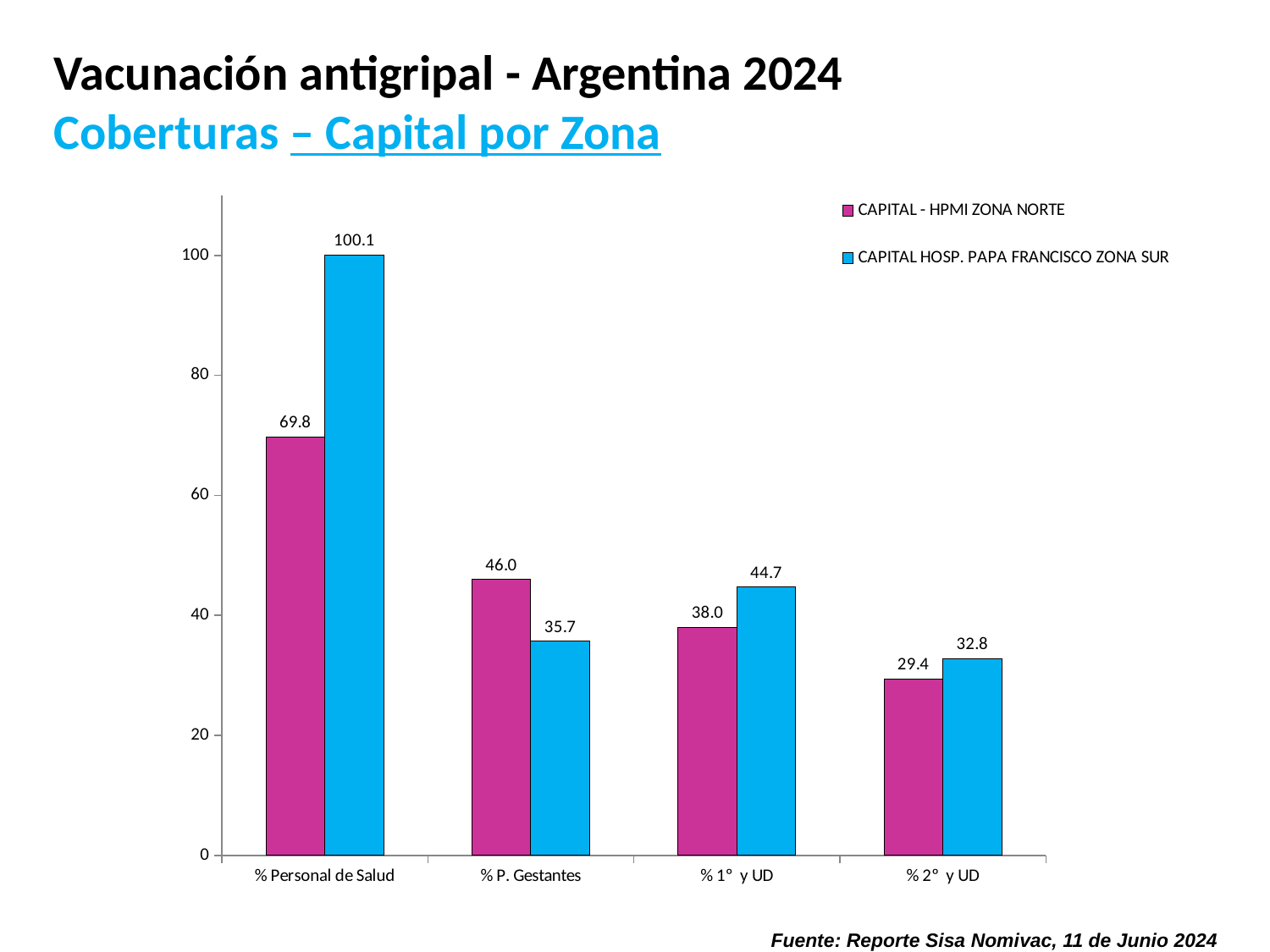
For % P. Gestantes, which series has the larger value? CAPITAL - HPMI ZONA NORTE How many series does the legend list? 2 What is the value for % P. Gestantes in the CAPITAL HOSP. PAPA FRANCISCO ZONA SUR series? 35.7 What kind of chart is shown on the slide? Bar chart Which category has the lowest value in the CAPITAL - HPMI ZONA NORTE series? % 2° y UD What is the difference between the two series for % 1° y UD? 6.7 Which category has the highest value in the CAPITAL HOSP. PAPA FRANCISCO ZONA SUR series? % Personal de Salud How many categories are shown on the x axis? 4 What is the difference between the two series for % Personal de Salud? 30.3 What is the value for % 2° y UD in the CAPITAL - HPMI ZONA NORTE series? 29.4 What is the value for % Personal de Salud in the CAPITAL - HPMI ZONA NORTE series? 69.8 What is the value for % Personal de Salud in the CAPITAL HOSP. PAPA FRANCISCO ZONA SUR series? 100.1